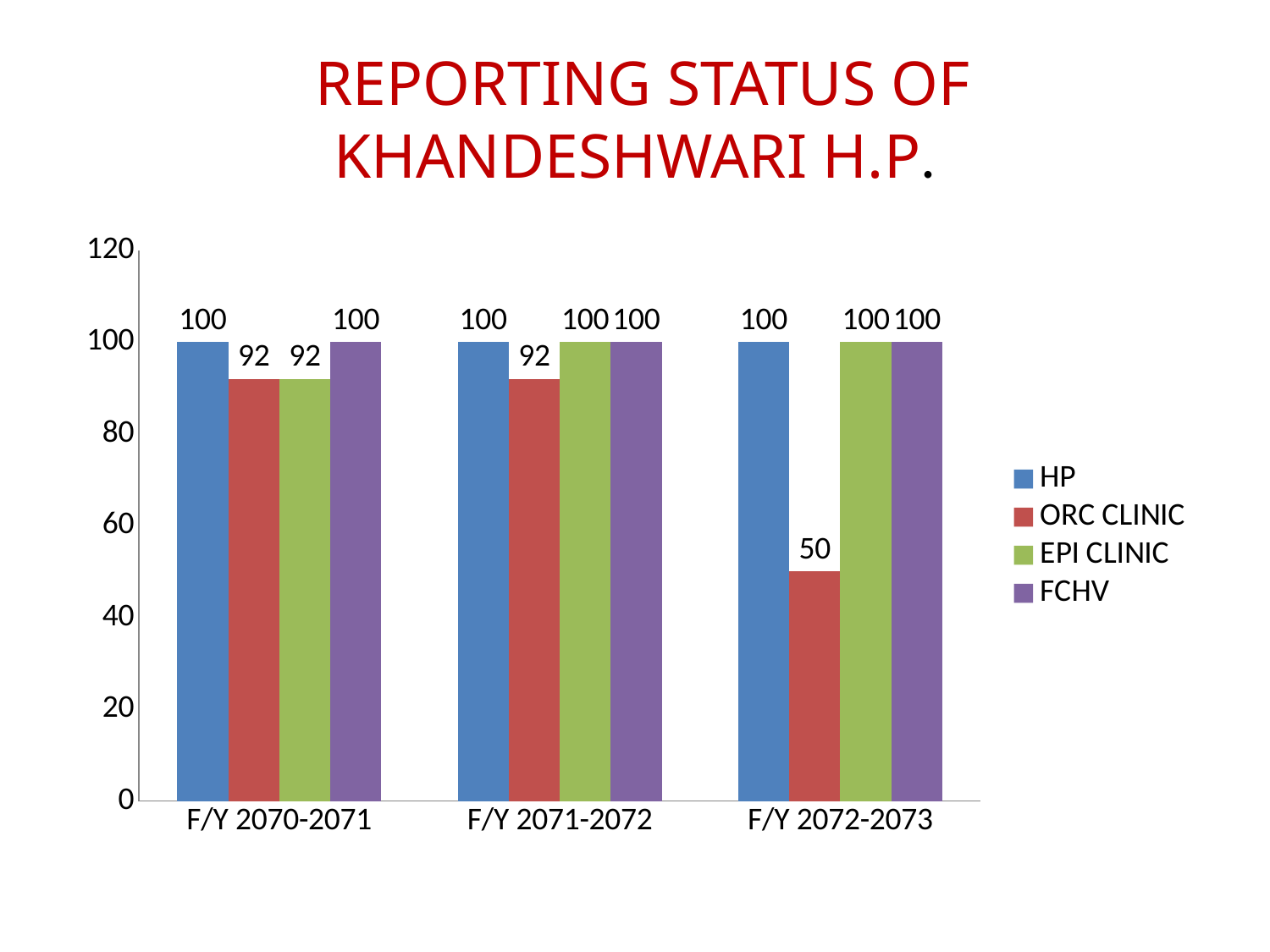
Do the ORC CLINIC values rise or fall from F/Y 2071-2072 to F/Y 2072-2073? Fall Which is larger, the ORC CLINIC value in F/Y 2071-2072 or in F/Y 2072-2073? F/Y 2071-2072 How many fiscal year categories are shown on the x axis? 3 What is the difference between the EPI CLINIC value in F/Y 2071-2072 and in F/Y 2070-2071? 8 What is the value for FCHV in F/Y 2072-2073? 100 What is the value for ORC CLINIC in F/Y 2072-2073? 50 How many series does the legend list? 4 What is the value for HP in F/Y 2071-2072? 100 What kind of chart is shown on the slide? Bar chart What is the difference between the HP value and the ORC CLINIC value in F/Y 2072-2073? 50 What is the value for EPI CLINIC in F/Y 2070-2071? 92 Which series has the lowest value in F/Y 2072-2073? ORC CLINIC